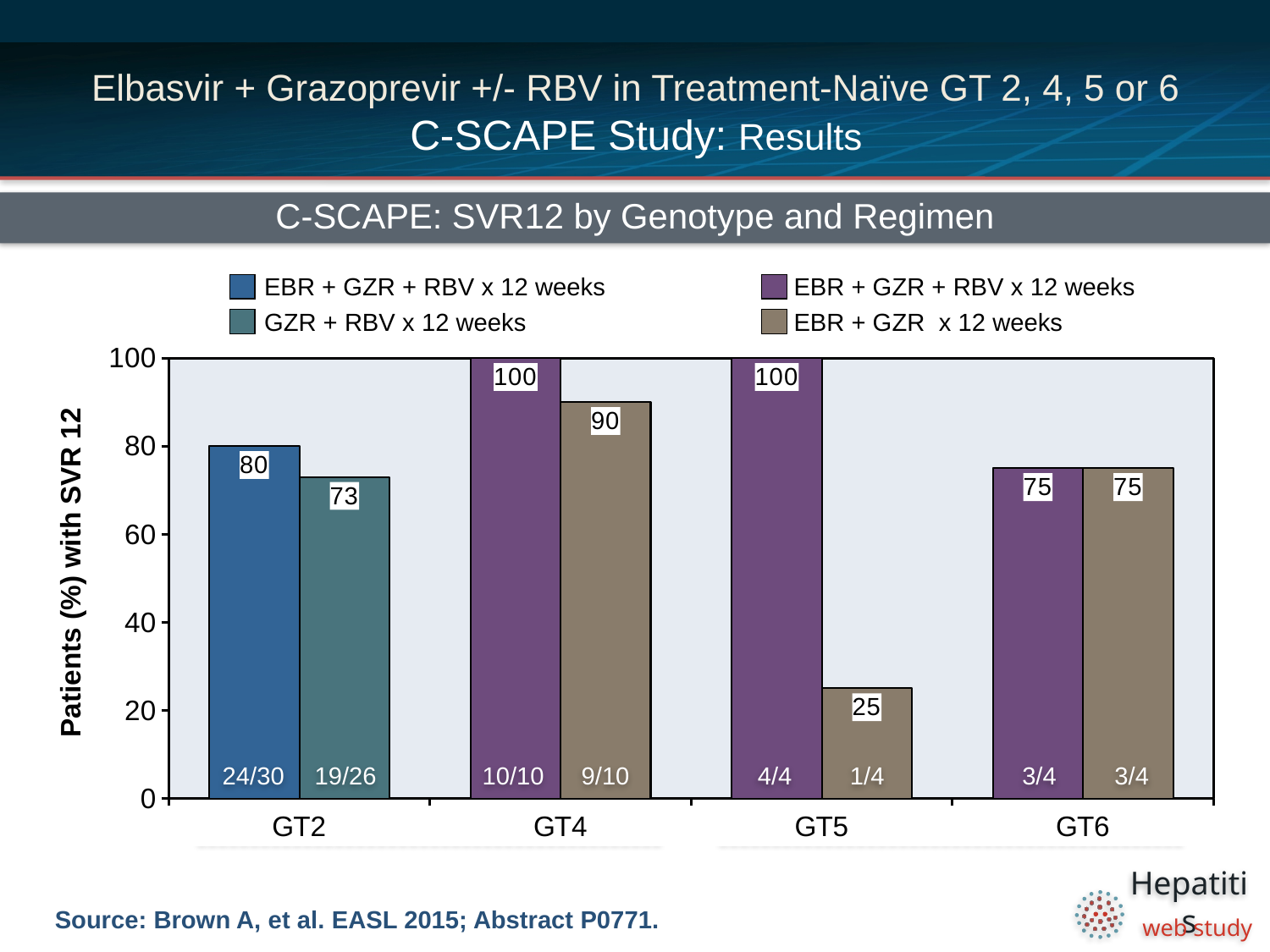
How many genotype groups are shown on the x axis? 4 In GT4, which regimen has the higher SVR12 rate? EBR + GZR + RBV x 12 weeks What is the SVR12 rate for the GZR + RBV x 12 weeks regimen in GT2? 73 What is the SVR12 rate for the EBR + GZR x 12 weeks regimen in GT4? 90 What is the difference in SVR12 rate between the two regimens in GT5? 75 What is the difference in SVR12 rate between the two regimens in GT2? 7 What is the SVR12 rate for the EBR + GZR x 12 weeks regimen in GT5? 25 What is the SVR12 rate for the EBR + GZR + RBV x 12 weeks regimen in GT2? 80 Which bar has the lowest SVR12 rate in the chart? EBR + GZR x 12 weeks in GT5 How many entries does the legend list? 4 What type of chart is shown on the slide? Bar chart What fraction of patients is shown for the GZR + RBV x 12 weeks bar in GT2? 19/26